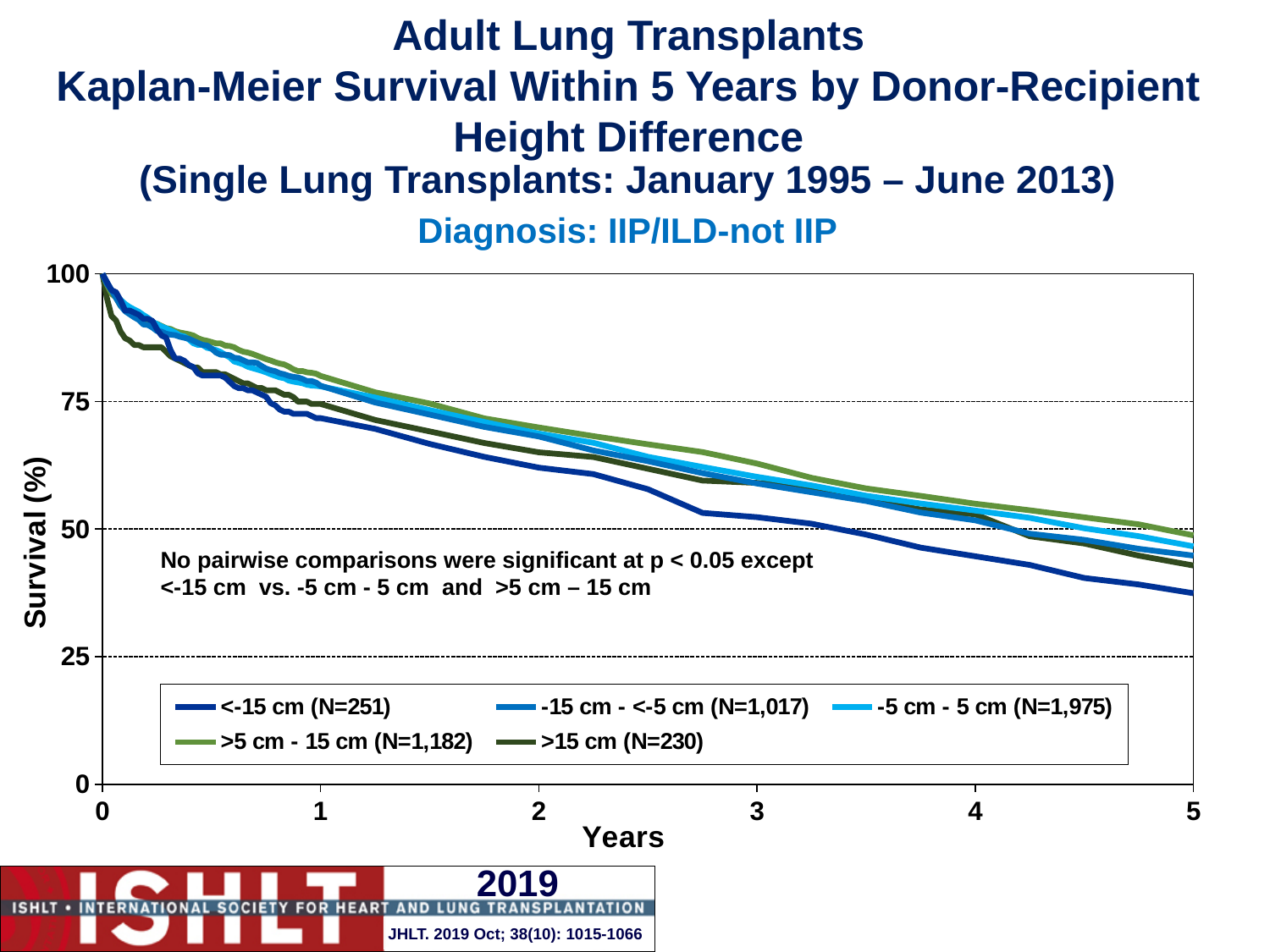
Do the survival curves rise or fall as years increase? fall Which height-difference group has the lowest survival at 5 years? <-15 cm (N=251) How many series does the legend list? 5 Is the survival for the >5 cm - 15 cm group at 1 year greater or less than 75? greater Is the survival for the <-15 cm group at 2 years greater or less than 50? greater What kind of chart is shown on the slide? line chart Is the survival for the <-15 cm group at 1 year greater or less than 75? less What is the label of the y axis? Survival (%) At 2 years, which group has higher survival: <-15 cm or >5 cm - 15 cm? >5 cm - 15 cm What is the N for the <-15 cm group in the legend? 251